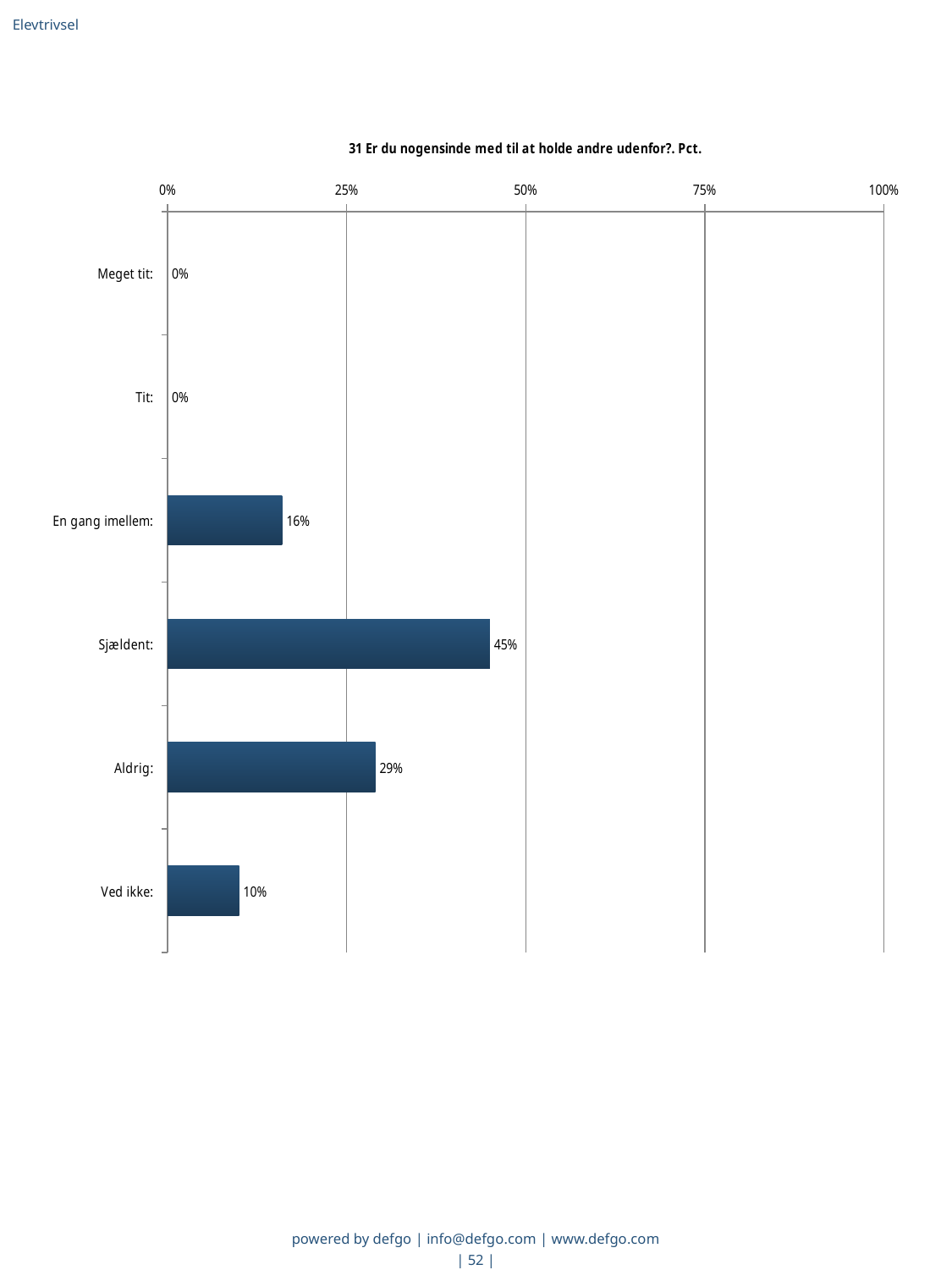
What is the value for Ved ikke? 10% Which is larger, the value for En gang imellem or the value for Ved ikke? En gang imellem What is the difference between the values for Sjældent and Aldrig? 16% What kind of chart is shown? bar chart What is the value for Sjældent? 45% What is the value for En gang imellem? 16% What is the value for Aldrig? 29% Which category has the highest value? Sjældent What is the title of the chart? 31 Er du nogensinde med til at holde andre udenfor?. Pct. What is the value for Tit? 0% Is the value for Aldrig greater or less than 25%? greater How many categories are shown on the chart? 6